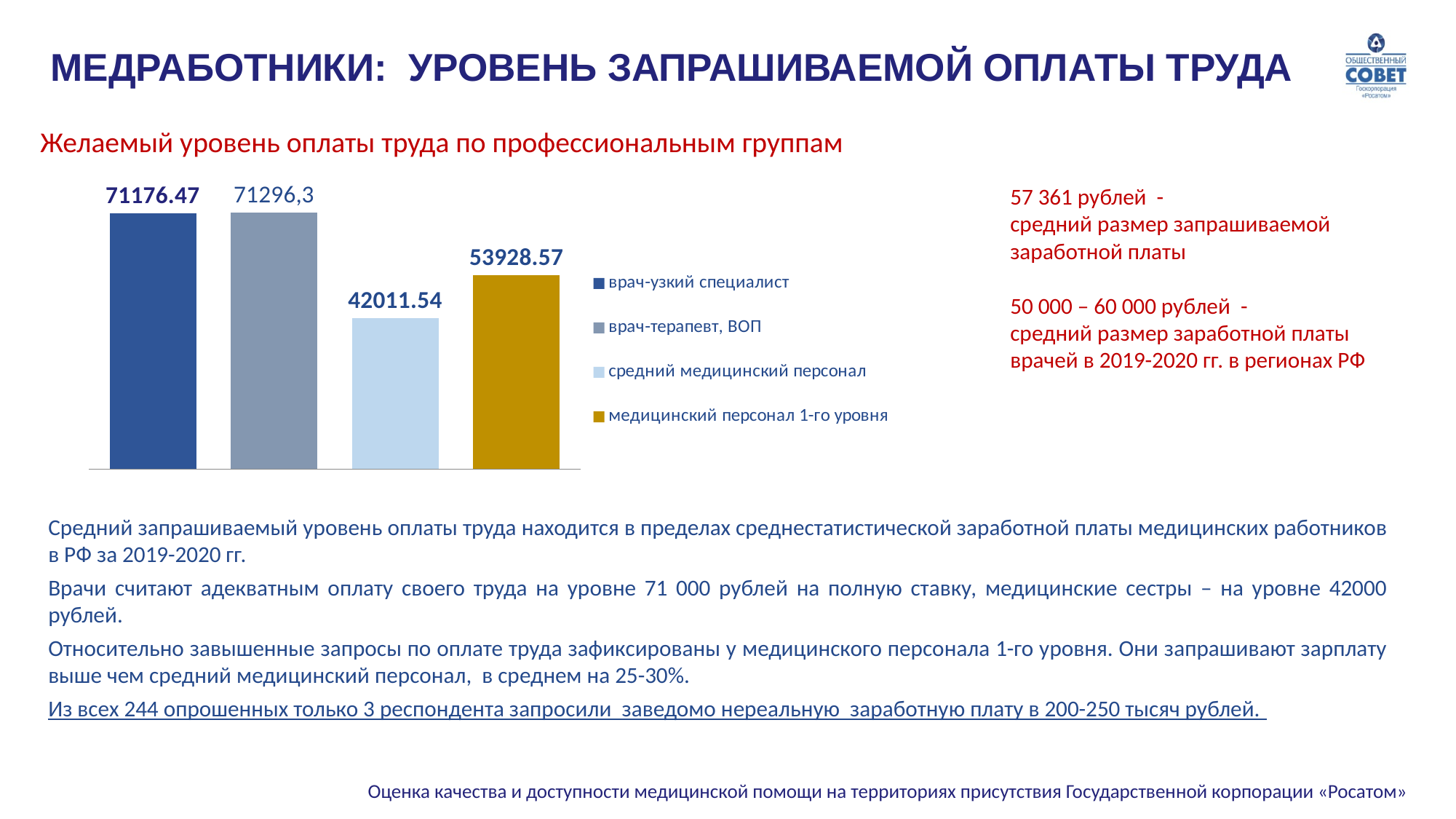
How many entries does the legend list? 4 What is the title of the chart? Желаемый уровень оплаты труда по профессиональным группам Which is larger: the value for медицинский персонал 1-го уровня or the value for средний медицинский персонал? медицинский персонал 1-го уровня What kind of chart is shown on the slide? bar chart What is the difference between the values for медицинский персонал 1-го уровня and средний медицинский персонал? 11917.03 What is the value for врач-узкий специалист? 71176.47 What is the value for средний медицинский персонал? 42011.54 Which category has the lowest value? средний медицинский персонал What is the value for врач-терапевт, ВОП? 71296,3 What is the value for медицинский персонал 1-го уровня? 53928.57 How many bars are plotted in the chart? 4 Which is larger: the value for врач-узкий специалист or the value for средний медицинский персонал? врач-узкий специалист